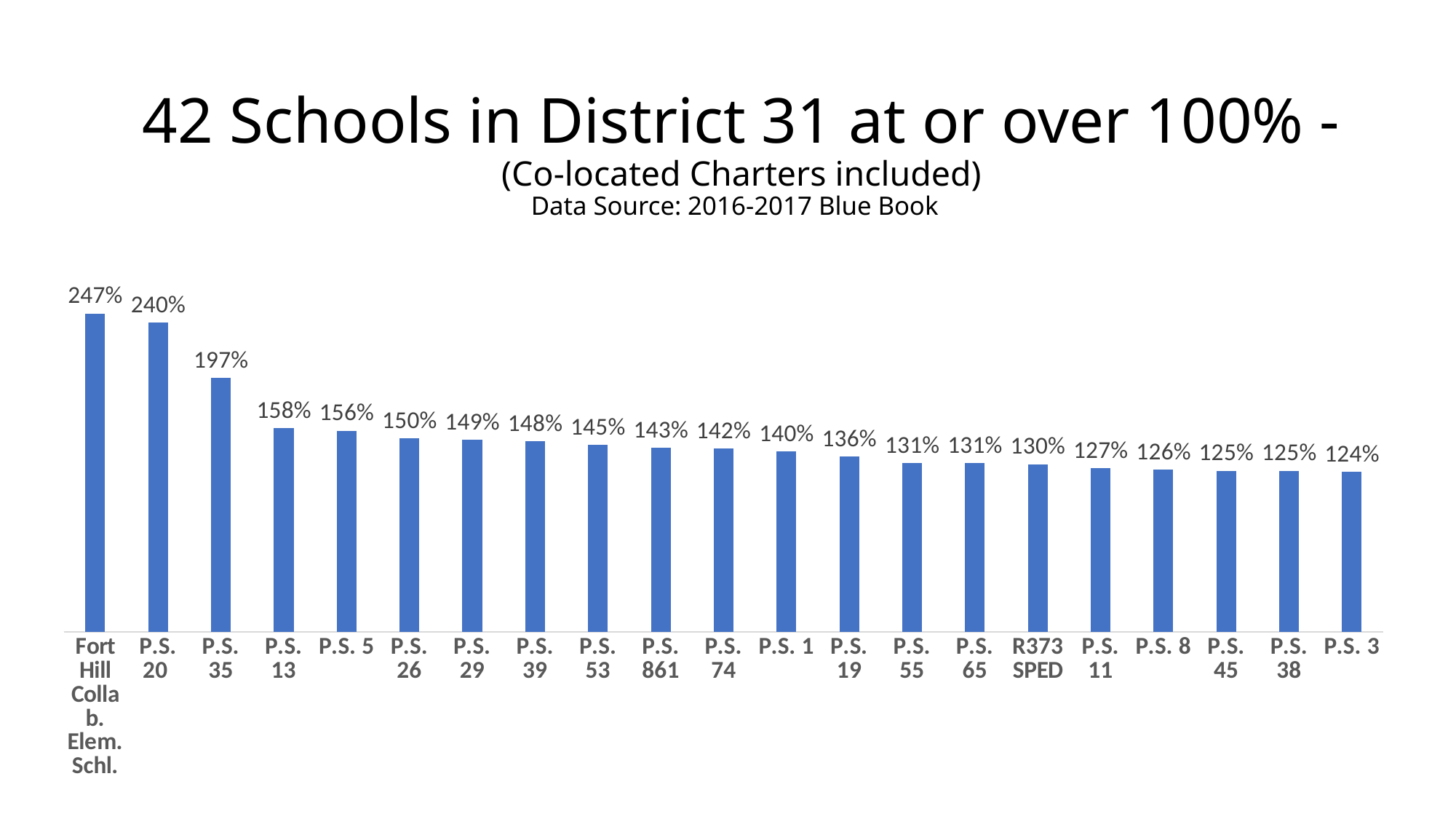
What is the value for R373 SPED? 130% What is the value for P.S. 20? 240% What kind of chart is shown on the slide? Bar chart What is the difference between the values for Fort Hill Collab. Elem. Schl. and P.S. 20? 7% What is the difference between the values for P.S. 35 and P.S. 13? 39% Which school has the highest value? Fort Hill Collab. Elem. Schl. What data source is cited in the chart title? 2016-2017 Blue Book Which school has the lowest value? P.S. 3 How many schools are shown in the chart? 21 Which is larger, the value for P.S. 26 or the value for P.S. 19? P.S. 26 Do the values rise or fall from left to right along the x axis? Fall What is the value for P.S. 861? 143%